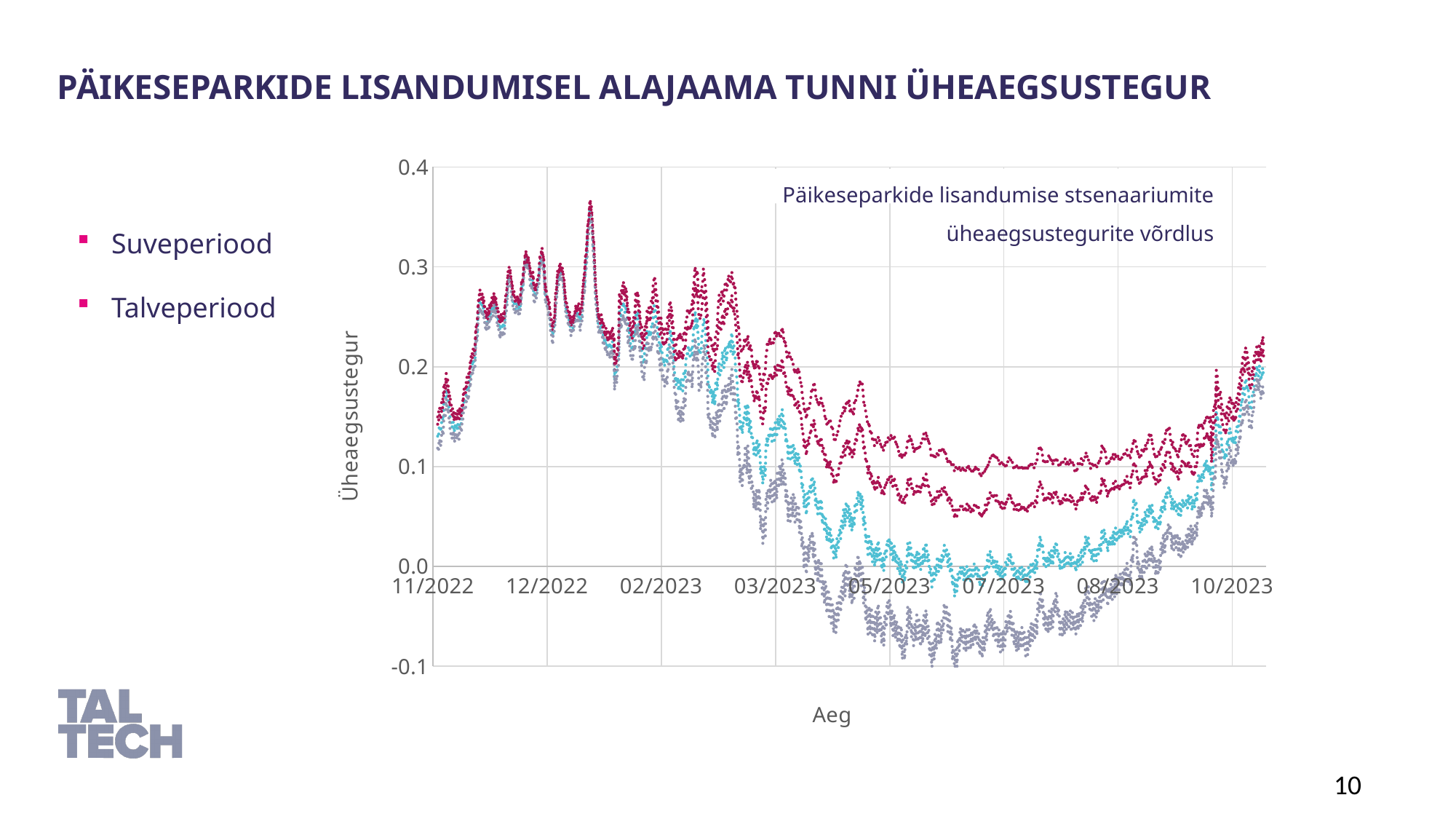
Is the lowest point reached by the grey series in the chart greater or less than 0.0? less Is the highest peak reached by any series in the chart greater or less than 0.3? greater Do the values in the chart rise or fall between 11/2022 and 12/2022? rise Around 07/2023, is the value of the cyan series greater or less than 0.1? less Do the values in the chart rise or fall between 03/2023 and 05/2023? fall How many date labels are shown along the x axis of the chart? 8 What is the first date label on the x axis of the chart? 11/2022 What kind of chart is shown on the slide? scatter chart What is the label of the vertical axis of the chart? Üheaegsustegur What is the lowest value shown on the y axis of the chart? -0.1 What is the title printed inside the chart? Päikeseparkide lisandumise stsenaariumite üheaegsustegurite võrdlus What is the highest value shown on the y axis of the chart? 0.4